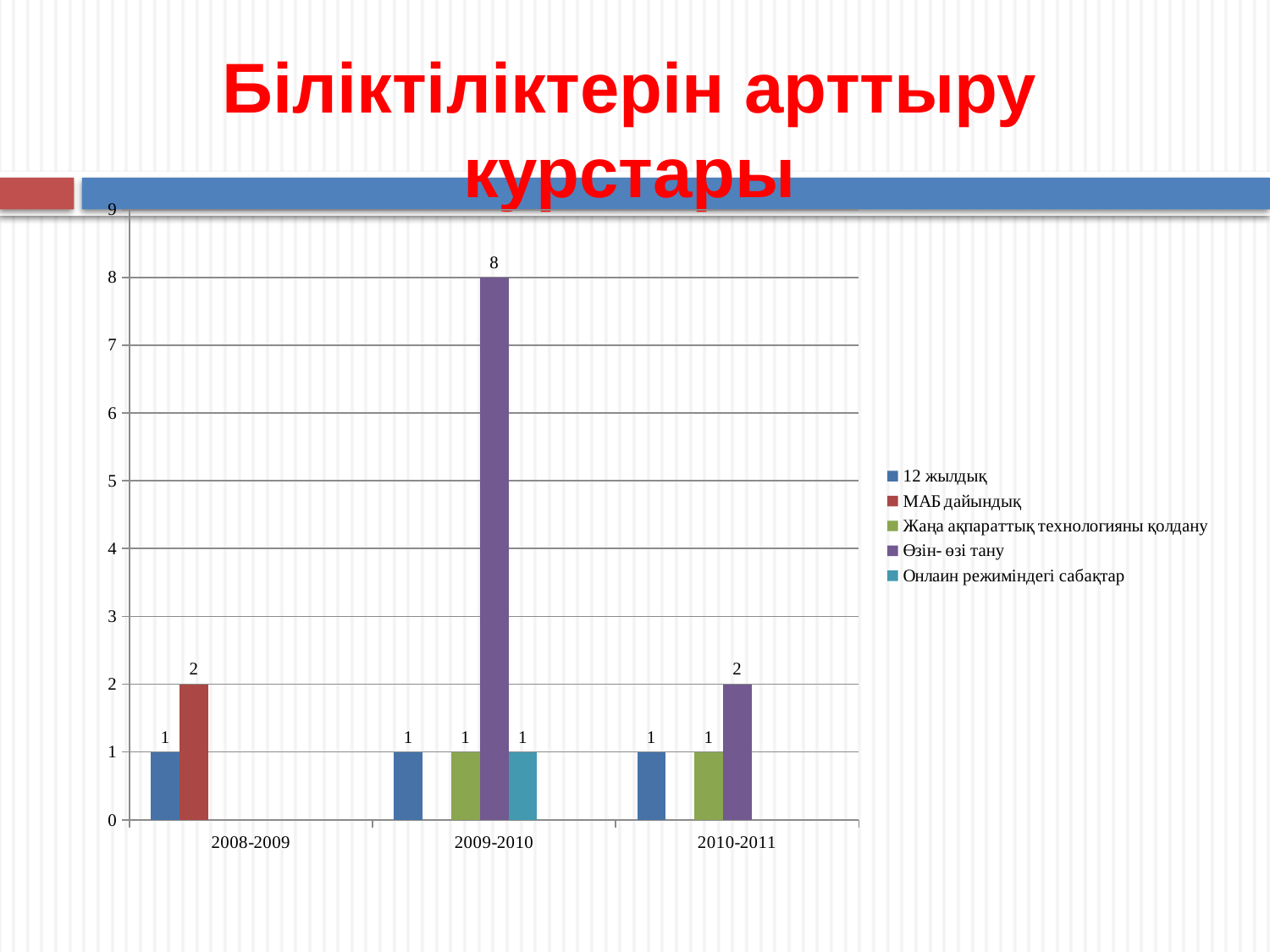
What is the title of the slide? Біліктіліктерін арттыру курстары What is the value for Өзін- өзі тану in 2010-2011? 2 What is the value for 12 жылдық in 2010-2011? 1 What is the value for Өзін- өзі тану in 2009-2010? 8 What kind of chart is shown on the slide? Bar chart How many series does the legend list? 5 What is the total of all values shown for 2009-2010? 11 How many categories are shown on the x axis? 3 What is the difference between the Өзін- өзі тану values for 2009-2010 and 2010-2011? 6 Which is larger in 2008-2009: 12 жылдық or МАБ дайындық? МАБ дайындық What is the value for МАБ дайындық in 2008-2009? 2 Which category has the highest value for Өзін- өзі тану? 2009-2010